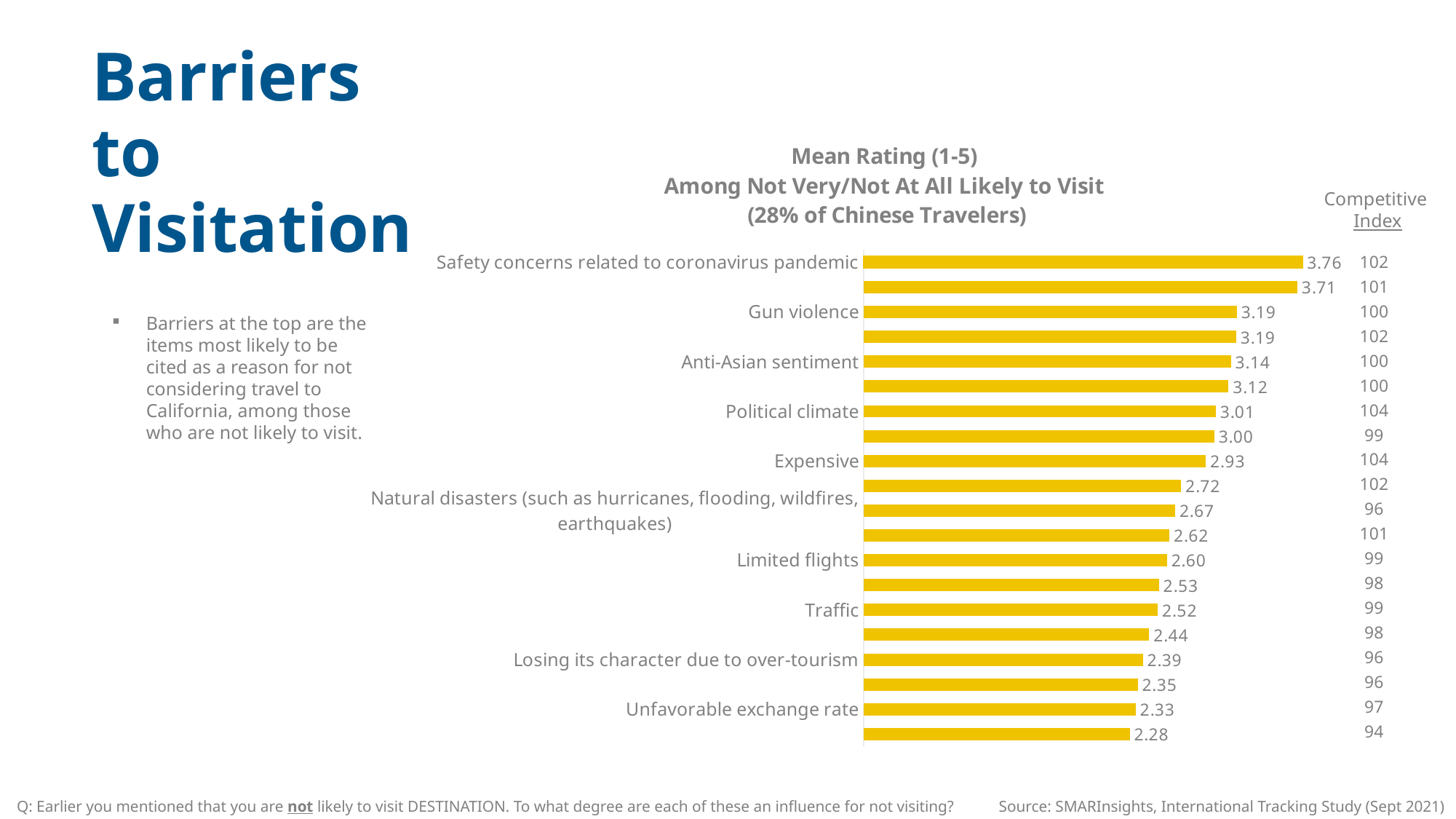
What is the mean rating for Safety concerns related to coronavirus pandemic? 3.76 What is the Competitive Index value for Political climate? 104 What is the lowest mean rating shown on the chart? 2.28 What is the difference between the mean ratings for Gun violence and Traffic? 0.67 What is the mean rating for Expensive? 2.93 Which barrier has the highest mean rating? Safety concerns related to coronavirus pandemic Which has a higher mean rating, Anti-Asian sentiment or Limited flights? Anti-Asian sentiment How many bars are plotted on the chart? 20 What kind of chart is shown on the slide? Bar chart What is the mean rating for Gun violence? 3.19 Do the mean ratings increase or decrease going from the top bar to the bottom bar? Decrease What is the mean rating for Traffic? 2.52